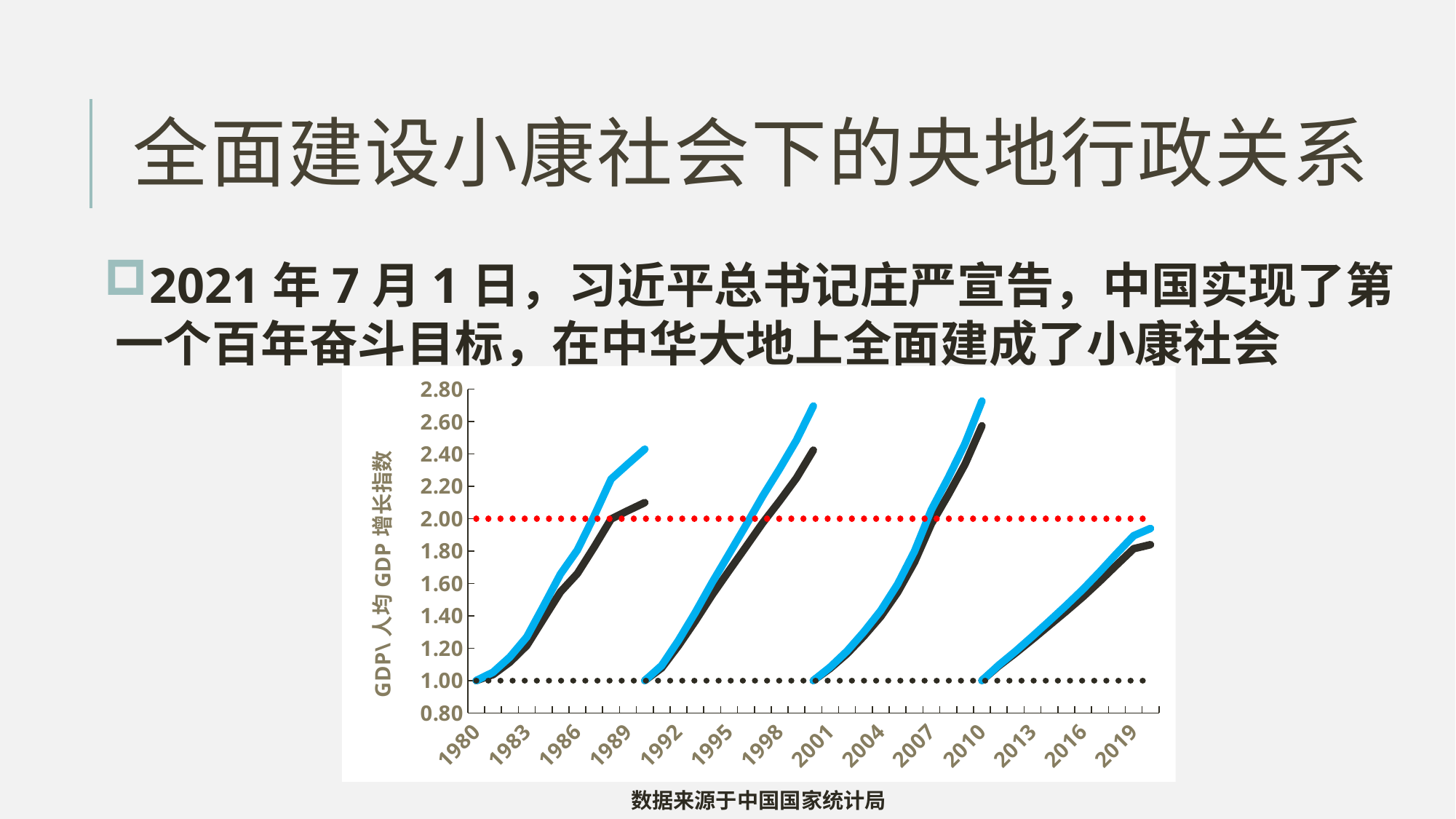
How many separate growth periods (line segments) are plotted on the chart? 4 What kind of chart is shown on the slide? line chart Within each ten-year period, do the lines rise or fall as the years increase? rise Is the value of the blue line at 1999 greater or less than 2.60? less How many year labels are shown on the horizontal axis? 14 Is the value of the blue line at 2019 greater or less than 2.00? less What is the label of the vertical axis of the chart? GDP\人均GDP增长指数 At what value on the vertical axis is the red dotted horizontal line drawn? 2.00 What is the value of the lines at the start of each period (1980, 1990, 2000, 2010)? 1.00 Is the value of the blue line at 1989 greater or less than 2.00? greater At what value on the vertical axis is the black dotted horizontal line drawn? 1.00